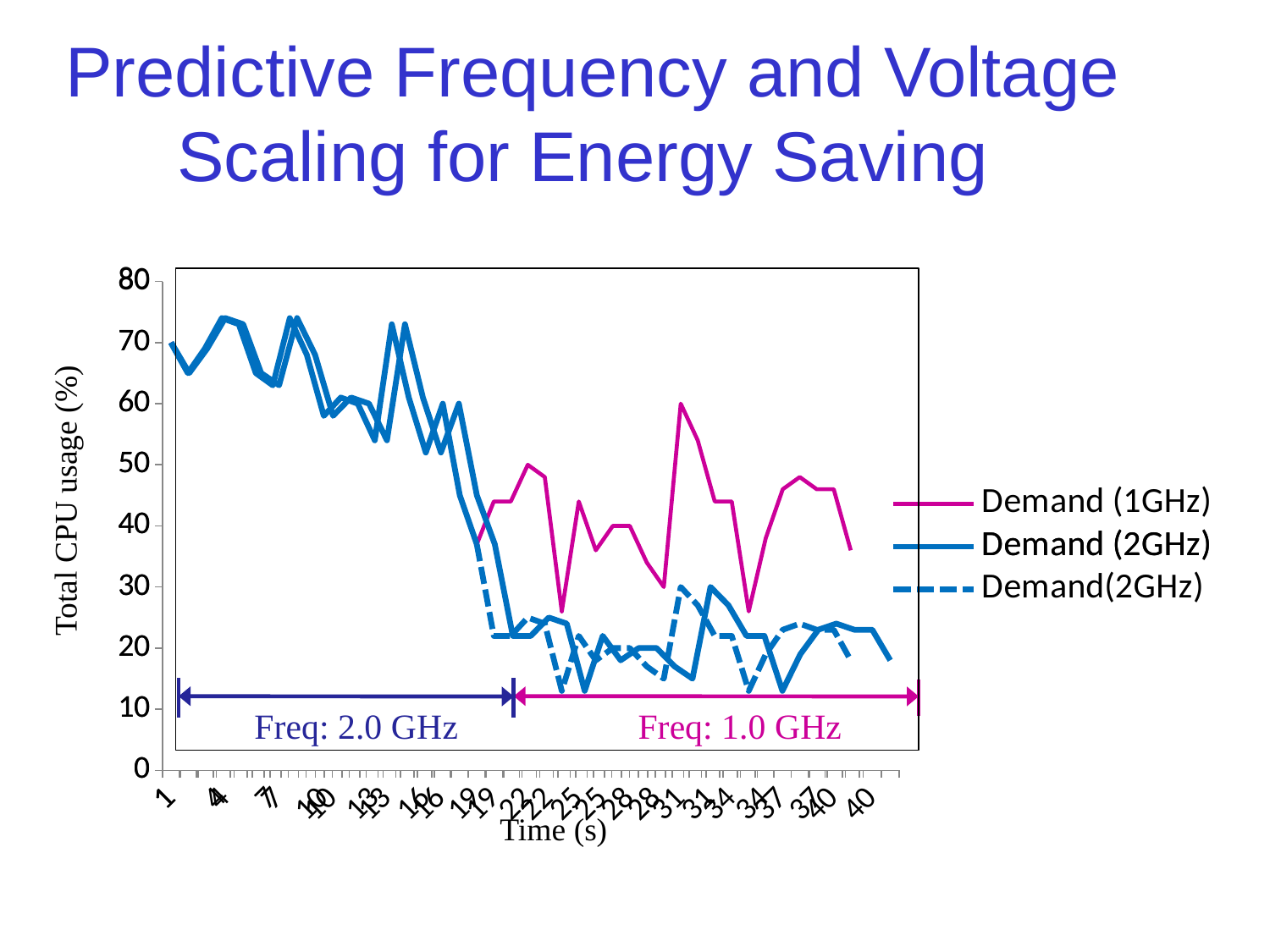
In the Freq: 1.0 GHz region, which series is higher, Demand (1GHz) or Demand (2GHz)? Demand (1GHz) Is the value of Demand (2GHz) at time 1 greater or less than 60? greater What kind of chart is shown on the slide? line chart Does the Demand (2GHz) series generally rise or fall as time increases? fall Is the value of Demand (2GHz) at time 40 greater or less than 30? less Which series reaches the highest value on the chart, Demand (1GHz) or Demand (2GHz)? Demand (2GHz) Is the highest value reached by the Demand (2GHz) series greater or less than 70? greater What frequency is annotated for the left portion of the chart? Freq: 2.0 GHz How many series does the legend list? 3 What is the label of the vertical axis? Total CPU usage (%)